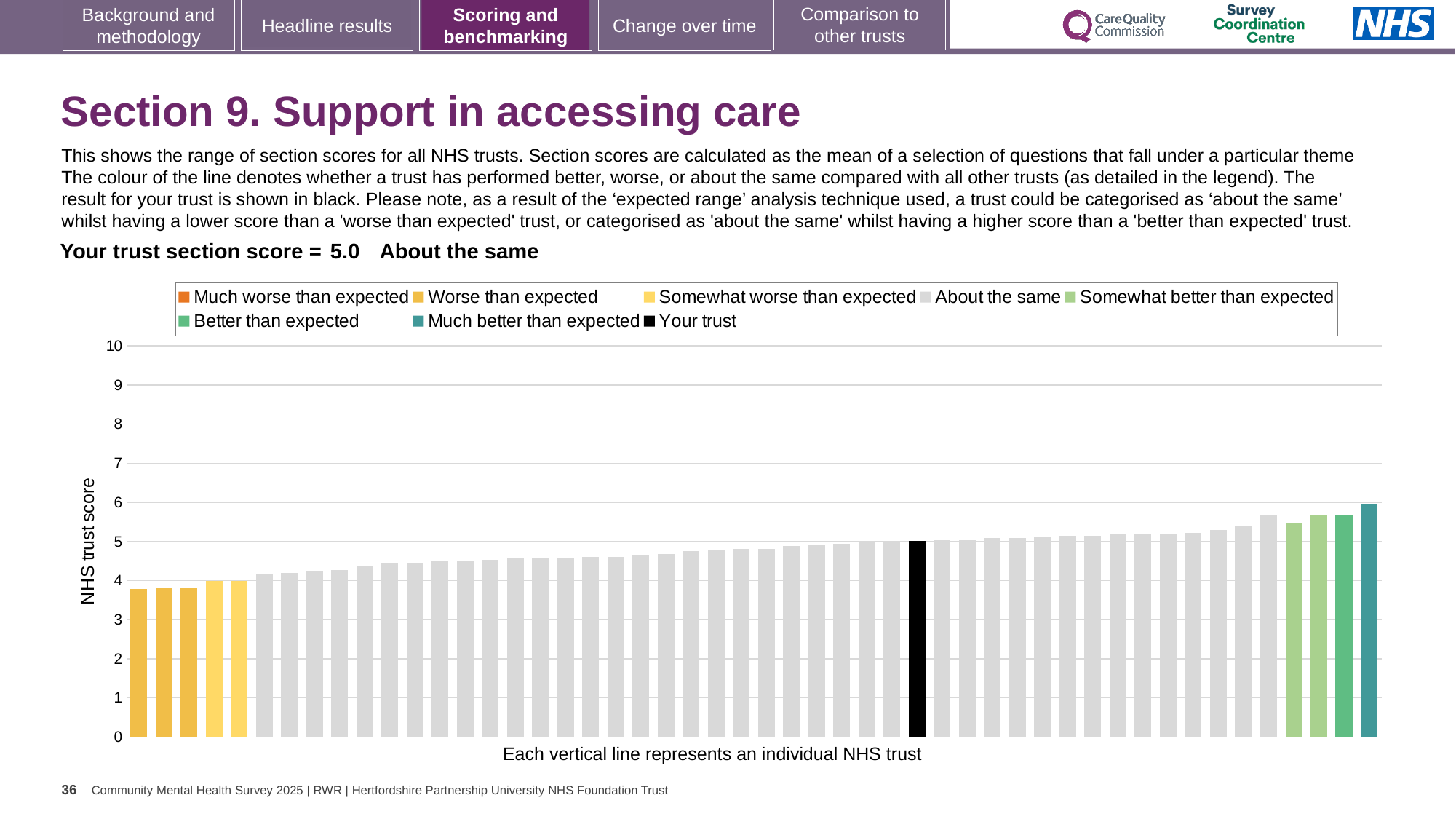
Is the value of the rightmost bar greater or less than 5? greater What is the section score for your trust shown on the slide? 5.0 What is the label on the vertical axis of the chart? NHS trust score Is the value of the leftmost bar greater or less than 4? less How many entries does the chart legend list? 8 Is the leftmost bar higher or lower than the black bar for your trust? lower Is the value of the black bar (your trust) greater or less than 4? greater What colour is used for the bar representing your trust? black Which legend category does the shortest bar belong to? Worse than expected What kind of chart is shown on the slide? bar chart Which legend category does the tallest bar belong to? Much better than expected Do the bar values rise or fall from left to right along the x axis? rise